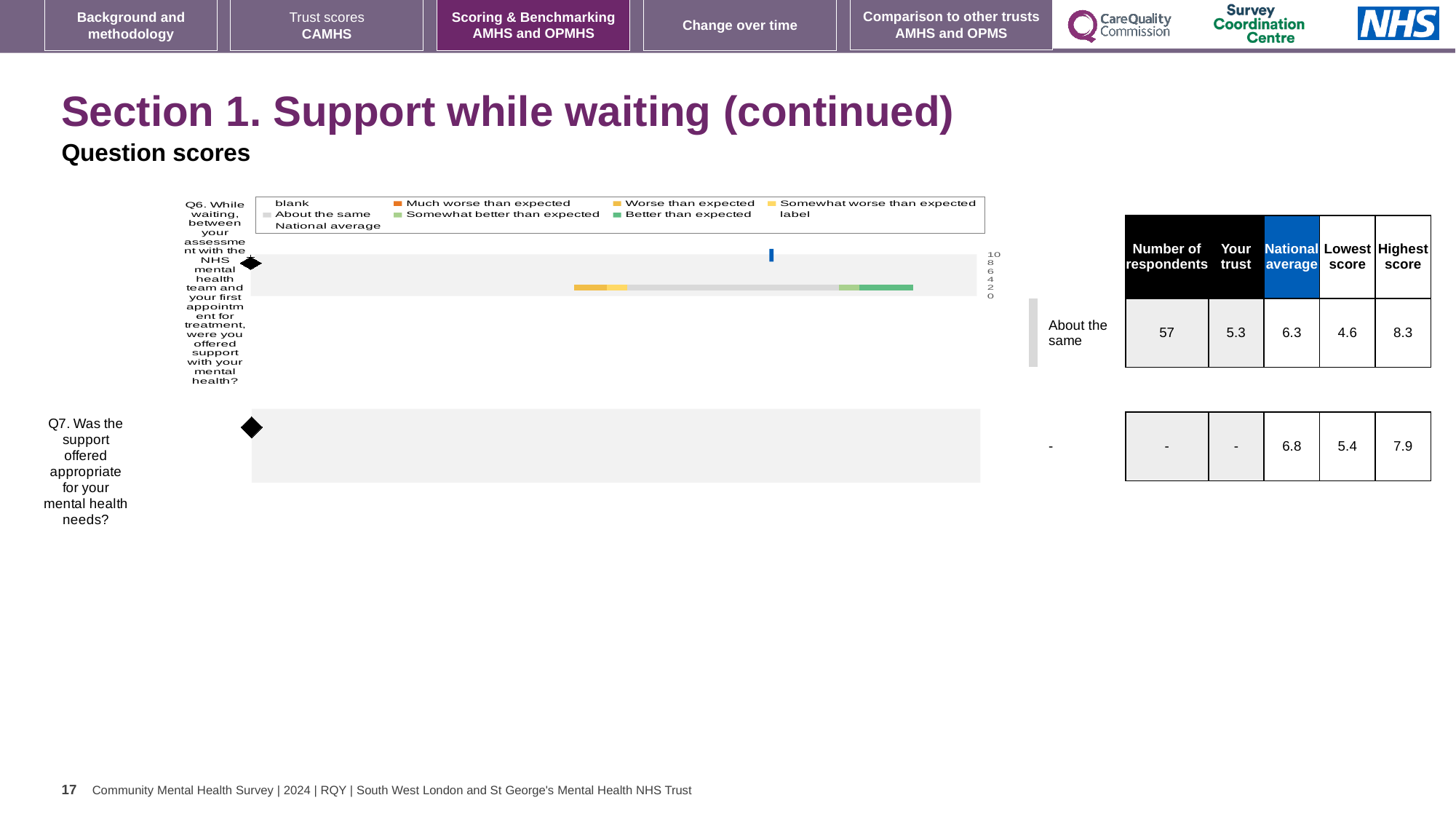
What is the lowest score for Q7? 5.4 How many respondents answered Q6 according to the table next to the chart? 57 What is the national average score for Q6? 6.3 What is the national average score for Q7? 6.8 What is the highest score for Q6? 8.3 What is the maximum value shown on the score axis of the Q6 chart? 10 Which benchmark category is the trust's Q6 score placed in? About the same For Q6, which is larger: the trust's score or the national average? national average What is the difference between the highest and lowest scores for Q6? 3.7 What is the trust's score for Q6? 5.3 What kind of chart is used to show the Q6 question score? bar chart